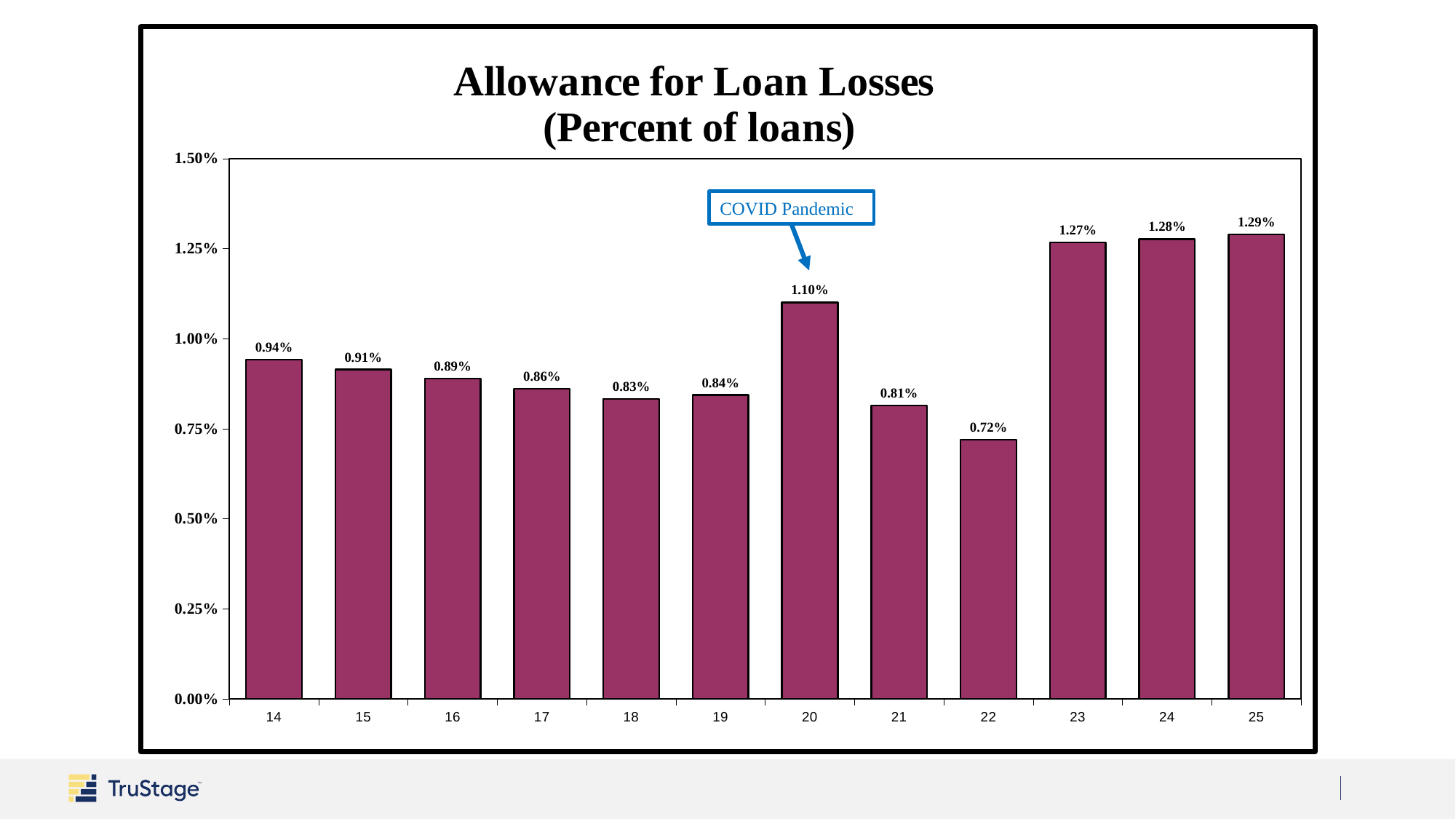
How many years are shown on the chart? 12 Do the values rise or fall from year 14 to year 18? Fall What is the allowance for loan losses in year 20? 1.10% Which year has the lowest allowance for loan losses? 22 Which year has the highest allowance for loan losses? 25 What is the allowance for loan losses in year 14? 0.94% What is the allowance for loan losses in year 22? 0.72% Which year has a larger allowance for loan losses, 16 or 21? 16 Which year does the 'COVID Pandemic' annotation point to? 20 What kind of chart is shown on the slide? Bar chart Is the value for year 23 greater or less than 1.00%? greater What is the difference between the allowance for loan losses in year 20 and year 19? 0.26%